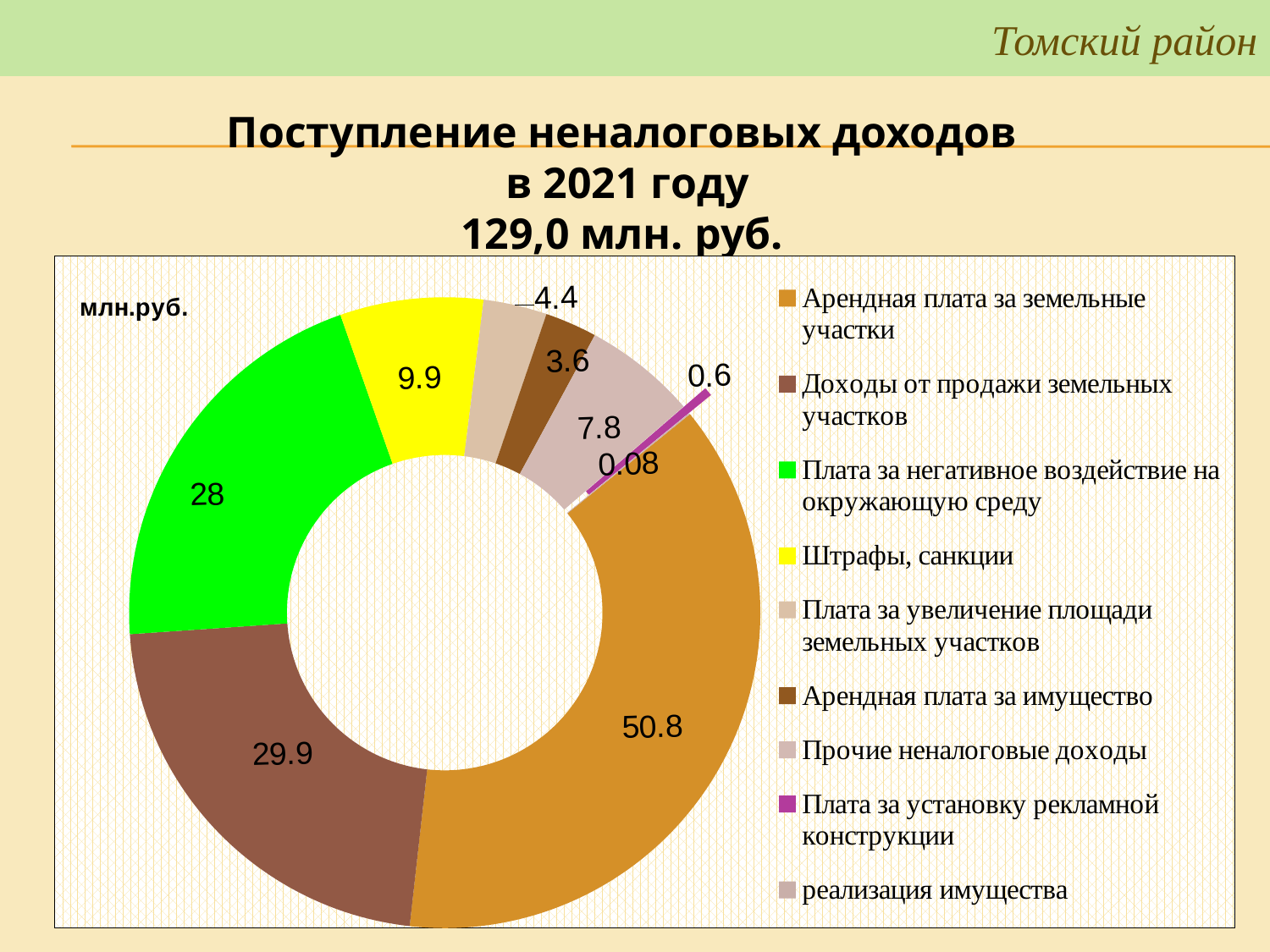
What is the value for Доходы от продажи земельных участков? 29.9 What is the value for Арендная плата за земельные участки? 50.8 Which is larger: Штрафы, санкции or Прочие неналоговые доходы? Штрафы, санкции What is the difference between Арендная плата за земельные участки and Доходы от продажи земельных участков? 20.9 What kind of chart is shown on the slide? Doughnut (pie) chart What is the value for Прочие неналоговые доходы? 7.8 What is the smallest data label shown on the chart? 0.08 Which category has the largest value? Арендная плата за земельные участки What is the value for Штрафы, санкции? 9.9 How many entries does the legend list? 9 What is the value for Плата за негативное воздействие на окружающую среду? 28 What unit is indicated in the top-left corner of the chart? млн.руб.